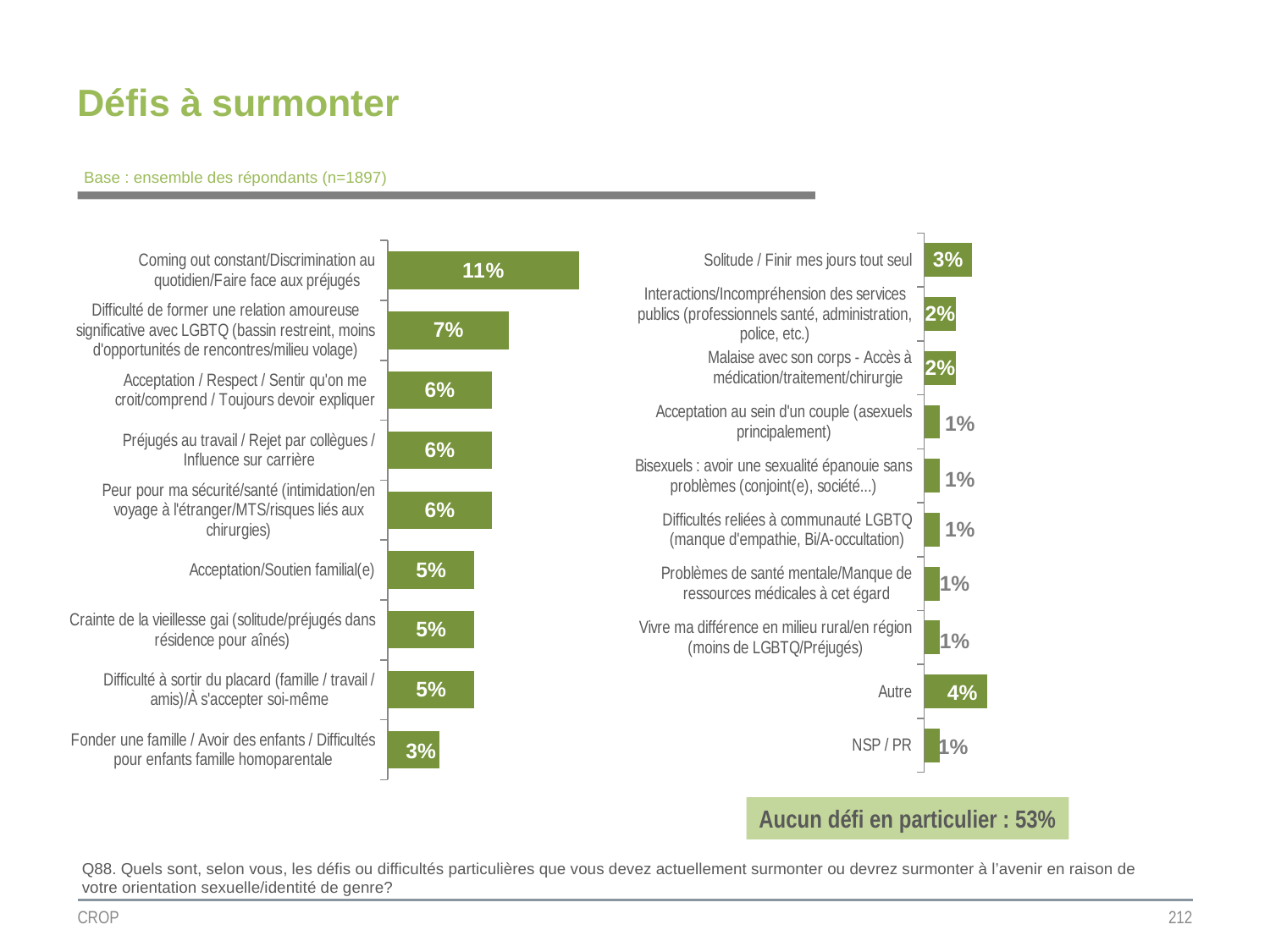
What type of chart is used on this slide? Bar chart How many categories are shown in the left chart? 9 In the left chart, what is the value for "Coming out constant/Discrimination au quotidien/Faire face aux préjugés"? 11% In the right chart, what is the value for "Autre"? 4% In the left chart, what is the value for "Acceptation/Soutien familial(e)"? 5% How many categories are shown in the right chart? 10 In the left chart, which category has the highest value? Coming out constant/Discrimination au quotidien/Faire face aux préjugés In the right chart, which is larger: the value for "Solitude / Finir mes jours tout seul" or the value for "Malaise avec son corps - Accès à médication/traitement/chirurgie"? Solitude / Finir mes jours tout seul In the right chart, which category has the highest value? Autre In the left chart, what is the difference between the values for "Coming out constant/Discrimination au quotidien/Faire face aux préjugés" and "Difficulté de former une relation amoureuse significative avec LGBTQ"? 4% In the left chart, which category has the lowest value? Fonder une famille / Avoir des enfants / Difficultés pour enfants famille homoparentale In the right chart, what is the value for "Solitude / Finir mes jours tout seul"? 3%